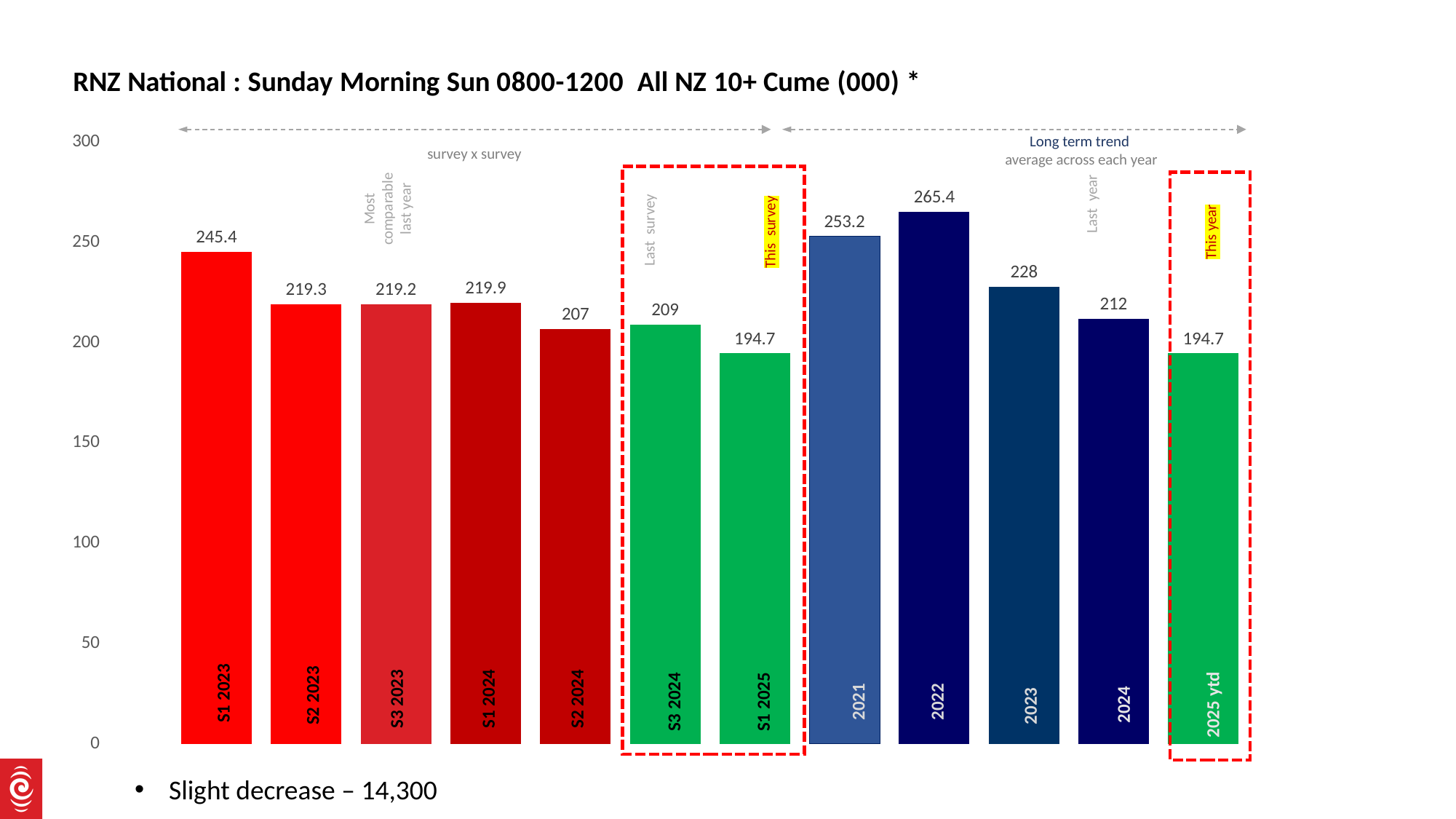
What is the value for S2 2024? 207 How many bars are shown on the chart? 12 Which is larger, the value for 2023 or the value for 2024? 2023 Which category has the highest value on the chart? 2022 Is the value for S1 2023 greater or less than 200? greater What is the value for the 2022 yearly average? 265.4 What type of chart is shown on the slide? bar chart What is the value for S3 2024? 209 What is the difference between S3 2024 and S1 2025? 14.3 What is the difference between the 2021 and 2022 yearly averages? 12.2 Which survey in the survey x survey section has the highest value? S1 2023 What is the value for S1 2025? 194.7